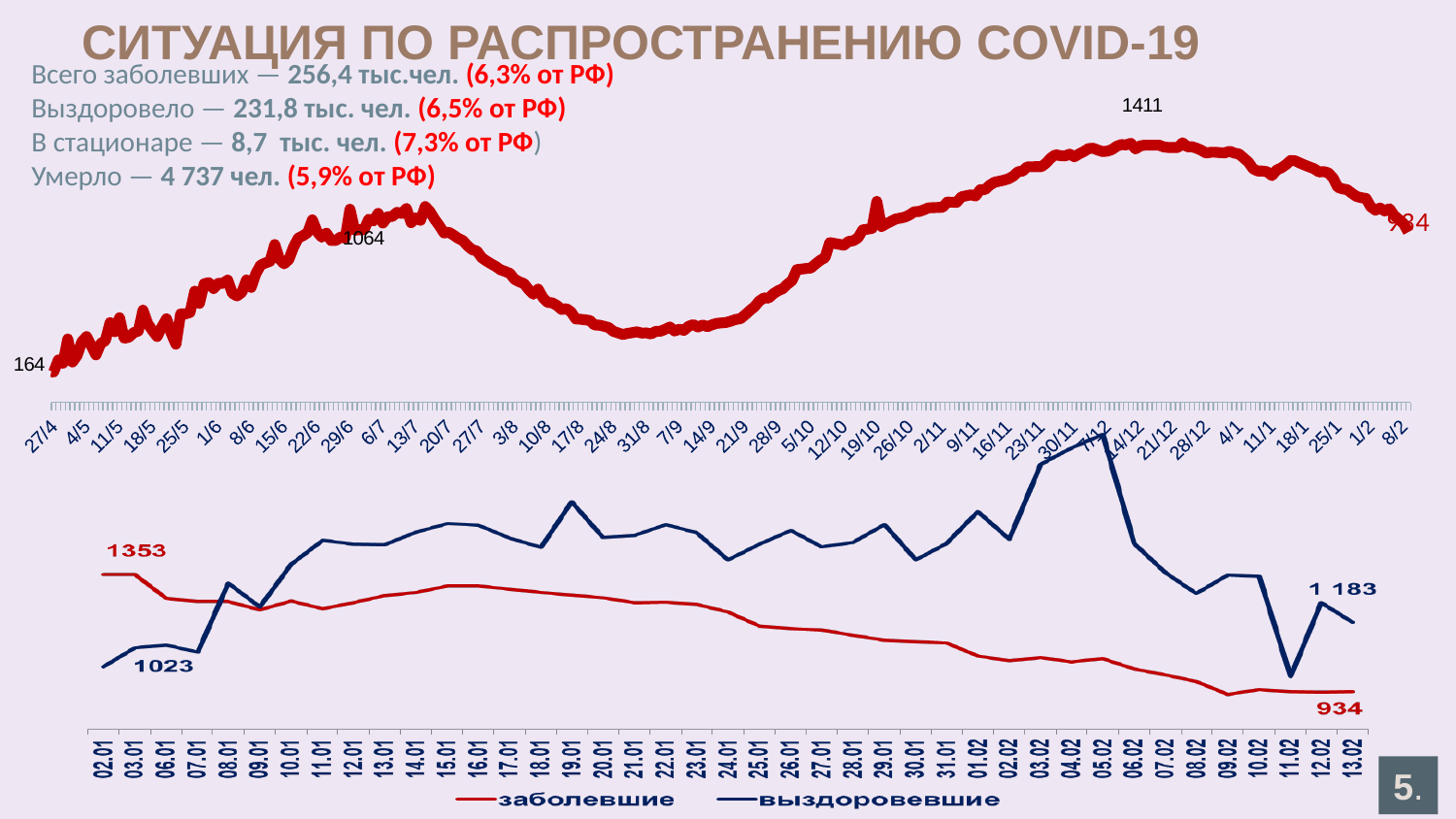
In the top chart, what value is labelled near 29/6? 1064 In the bottom chart, what is the value of выздоровевшие on 13.02? 1 183 In the top chart, what is the value labelled at the start of the line (27/4)? 164 What kind of chart is the top chart on the slide? line chart In the bottom chart, on 13.02 which series is higher, заболевшие or выздоровевшие? выздоровевшие In the bottom chart, what colour is the заболевшие line? red In the bottom chart, by how much did заболевшие fall from 02.01 (1353) to 13.02 (934)? 419 In the top chart, what is the highest labelled value? 1411 How many series does the legend of the bottom chart list? 2 In the top chart, what is the value labelled at the end of the line (8/2)? 934 In the bottom chart, what is the value of заболевшие on 13.02? 934 In the bottom chart, what is the value of заболевшие on 02.01? 1353